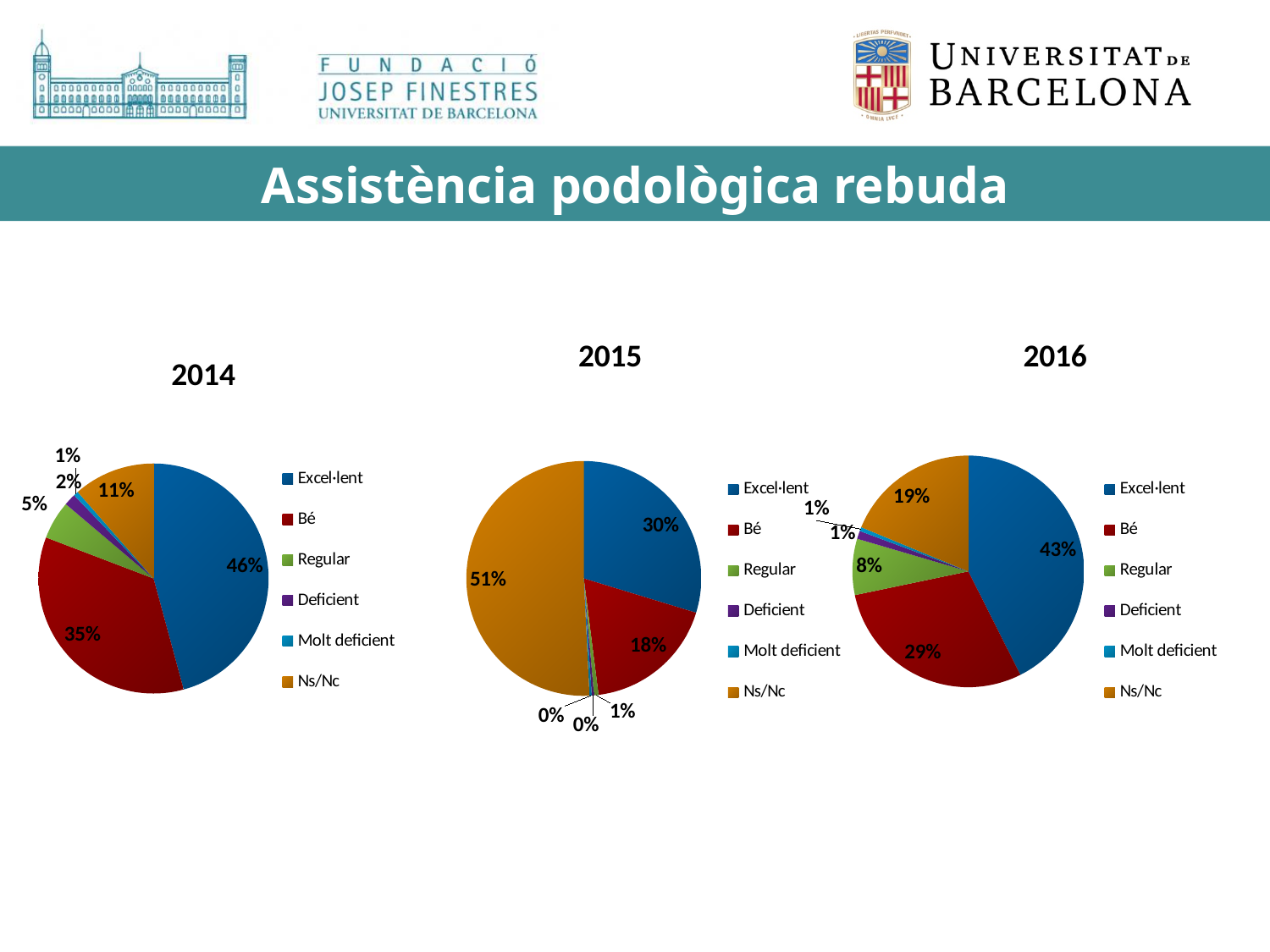
In the 2015 chart, what is the value for Bé? 18% What is the title of the chart on the left of the slide? 2014 In the 2014 chart, what share of the pie is Excel·lent? 46% In the 2014 chart, what is the value for Ns/Nc? 11% In the 2015 chart, which category has the largest slice? Ns/Nc In the 2016 chart, which category has the largest slice? Excel·lent What kind of chart is the 2015 chart? Pie chart How many categories does the legend of the 2016 chart list? 6 In the 2014 chart, what is the difference between Excel·lent and Bé? 11% In the 2016 chart, which is larger, Bé or Ns/Nc? Bé In the 2016 chart, what is the value for Regular? 8% In the 2015 chart, what is the difference between Ns/Nc and Excel·lent? 21%